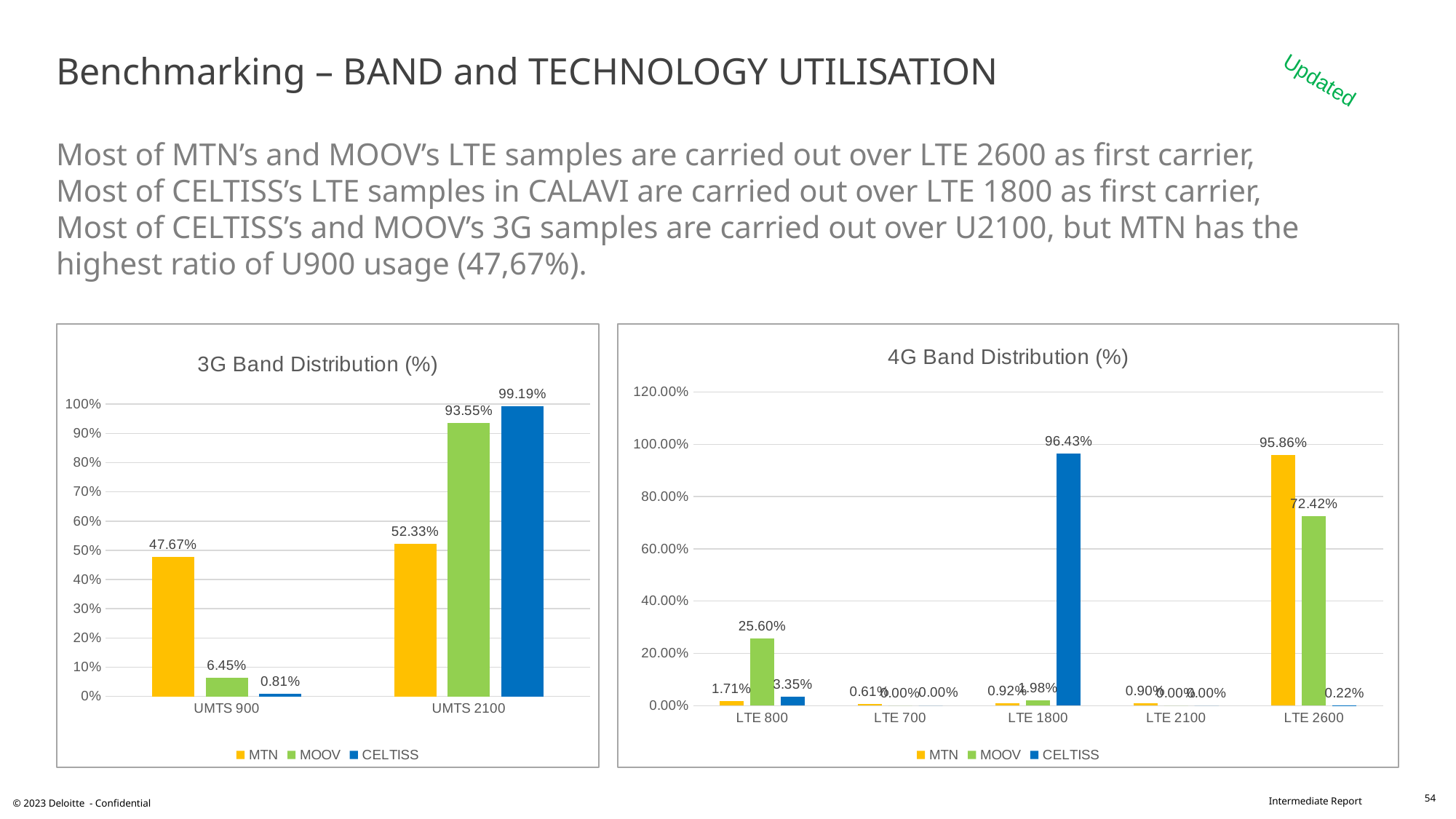
In the 4G Band Distribution (%) chart, which operator has the highest value on LTE 2600? MTN In the 4G Band Distribution (%) chart, what is the value for CELTISS on LTE 1800? 96.43% In the 3G Band Distribution (%) chart, what is the value for MTN on UMTS 900? 47.67% In the 3G Band Distribution (%) chart, what is the difference between MOOV's values on UMTS 2100 and UMTS 900? 87.10% In the 3G Band Distribution (%) chart, which operator has the highest value on UMTS 2100? CELTISS In the 4G Band Distribution (%) chart, what is the value for MOOV on LTE 800? 25.60% In the 4G Band Distribution (%) chart, is the value for MTN on LTE 2600 larger or smaller than the value for MOOV on LTE 2600? larger In the 4G Band Distribution (%) chart, how many LTE band categories are shown on the x axis? 5 What kind of chart is the 4G Band Distribution (%) chart? bar chart In the 3G Band Distribution (%) chart, what is the value for CELTISS on UMTS 2100? 99.19% In the 3G Band Distribution (%) chart, which operator has the lowest value on UMTS 900? CELTISS In the 3G Band Distribution (%) chart, how many series does the legend list? 3